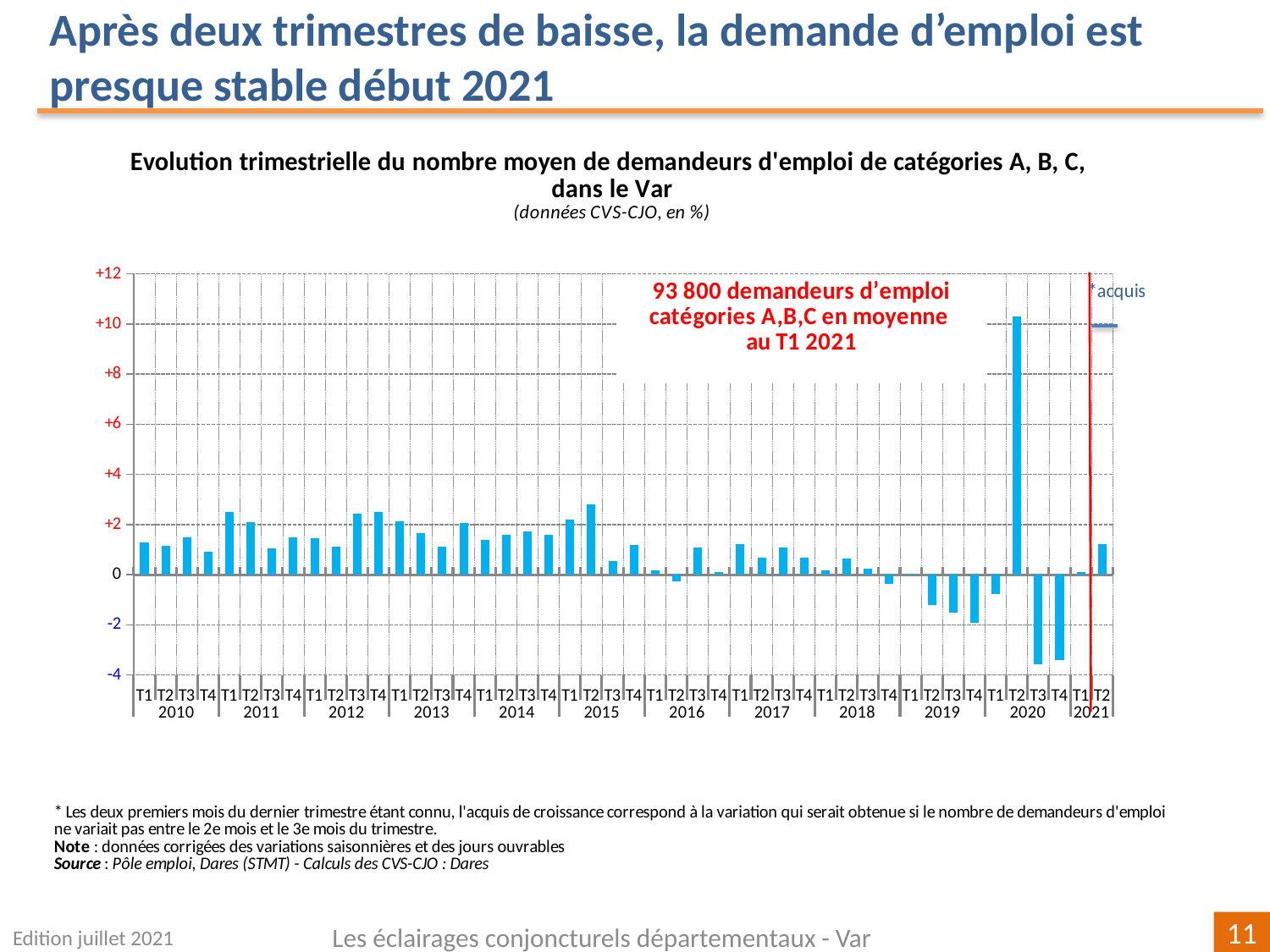
What kind of chart is shown on the slide? bar chart Is the value for T2 2021 greater or less than 0? greater Is the value for T4 2019 greater or less than 0? less Which is larger, the value for T1 2010 or the value for T1 2011? T1 2011 How many quarterly bars are plotted in the chart? 46 Do the values rise or fall from T2 2020 to T4 2020? fall Is the value for T3 2020 greater or less than -2? less Which quarter has the highest value in the chart? T2 2020 Which is lower, the value for T4 2019 or the value for T3 2020? T3 2020 According to the annotation on the chart, what was the average number of category A, B, C job seekers in T1 2021? 93 800